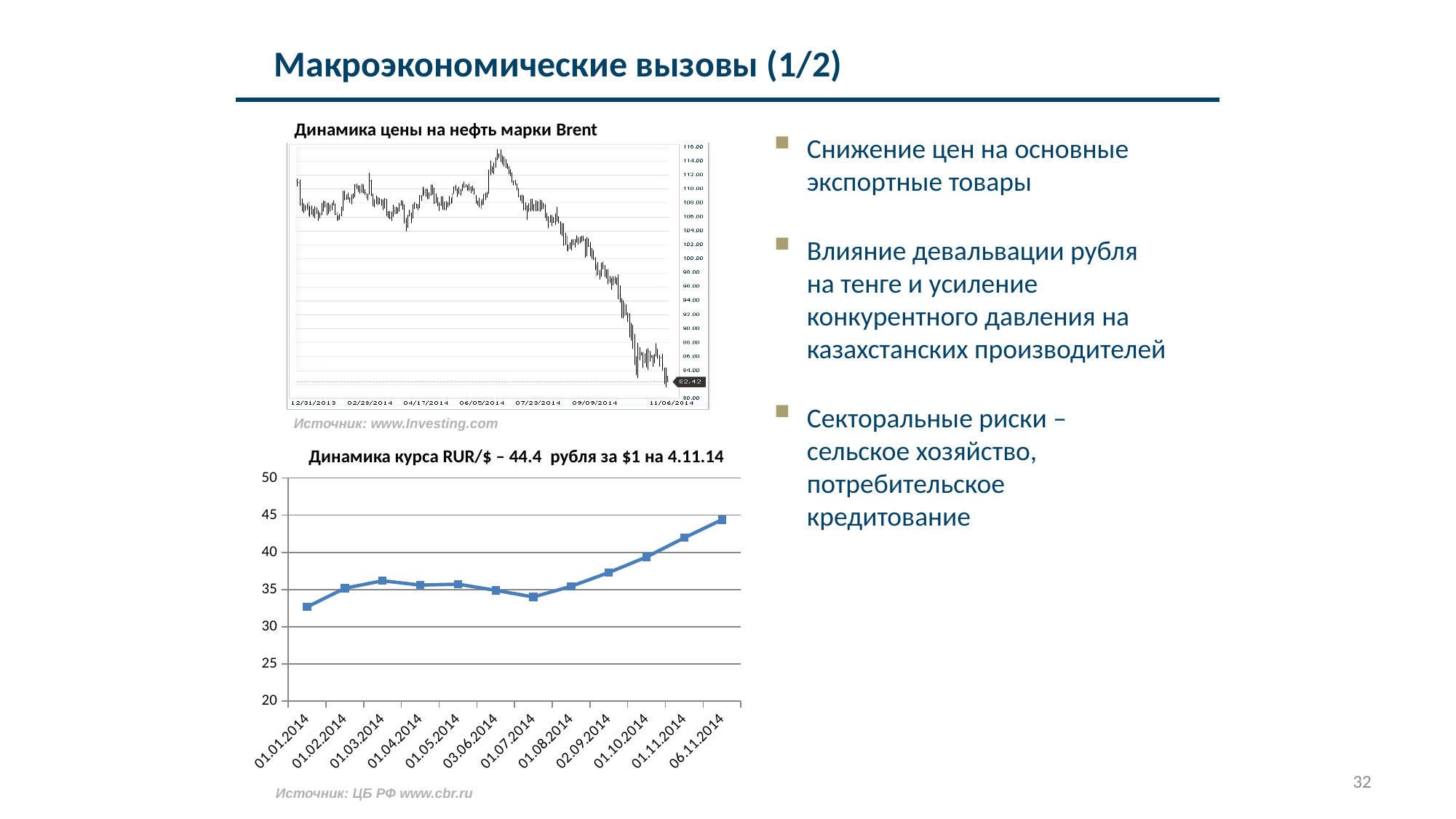
How many data points are plotted on the bottom chart "Динамика курса RUR/$"? 12 On the bottom chart "Динамика курса RUR/$", which date has the lowest value? 01.01.2014 What source is cited below the bottom chart "Динамика курса RUR/$"? ЦБ РФ www.cbr.ru What kind of chart is the bottom chart titled "Динамика курса RUR/$"? line chart On the bottom chart "Динамика курса RUR/$", which is larger: the value for 01.11.2014 or the value for 01.07.2014? 01.11.2014 On the bottom chart "Динамика курса RUR/$", is the value for 01.07.2014 greater or less than 35? less On the top chart "Динамика цены на нефть марки Brent", what is the last price value labelled on the chart? 82.42 On the bottom chart "Динамика курса RUR/$", is the value for 01.11.2014 greater or less than 40? greater On the bottom chart "Динамика курса RUR/$", do the values rise or fall from 01.08.2014 to 06.11.2014? rise On the bottom chart "Динамика курса RUR/$", is the value for 01.01.2014 greater or less than 35? less On the top chart "Динамика цены на нефть марки Brent", does the price overall rise or fall from 06/05/2014 to 11/06/2014? fall On the bottom chart "Динамика курса RUR/$", which date has the highest value? 06.11.2014